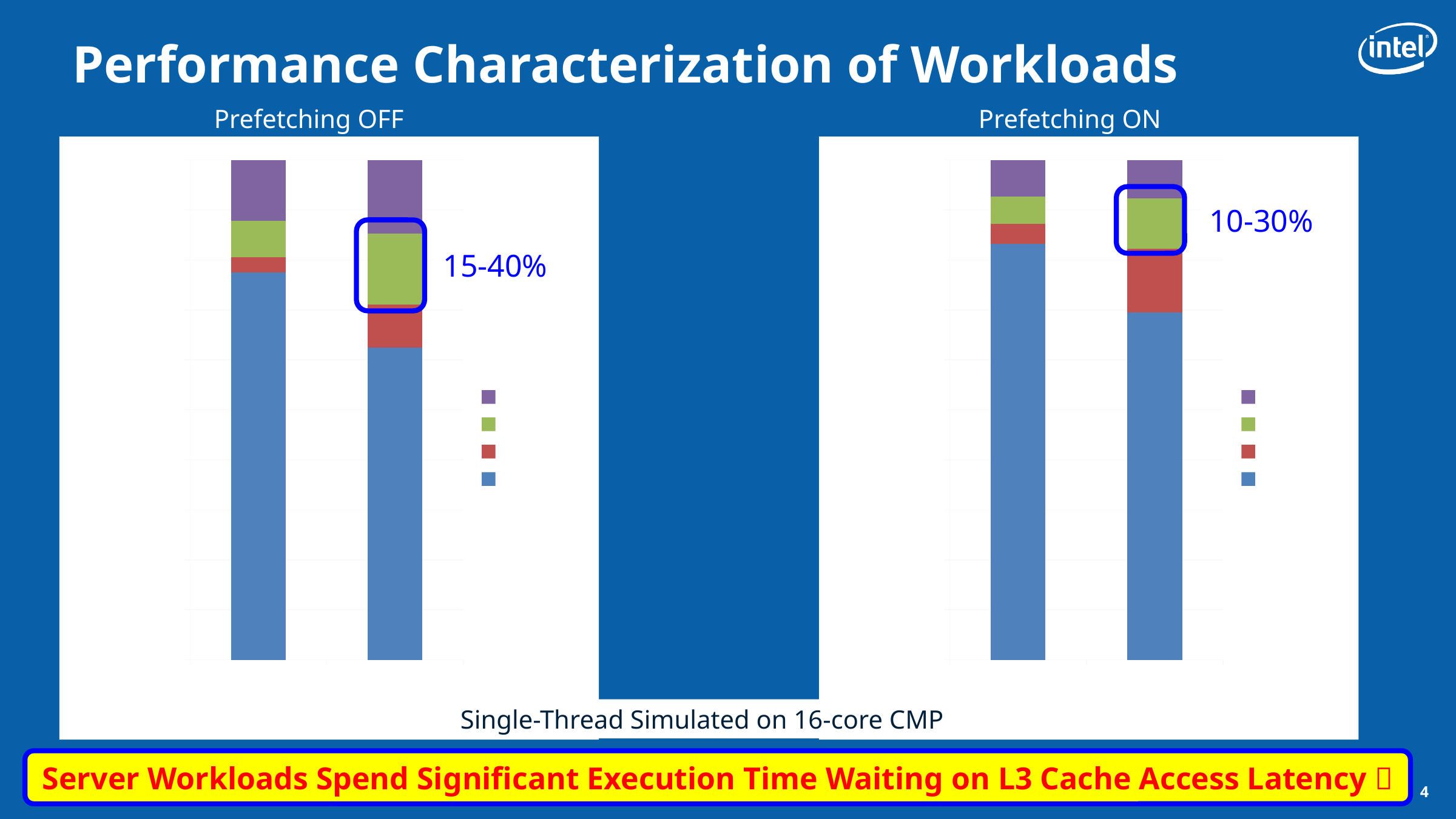
In the "Prefetching ON" chart, what percentage range is annotated next to the highlighted green segment? 10-30% In the "Prefetching OFF" chart, what percentage range is annotated next to the highlighted green segment? 15-40% What are the headings of the two charts on the slide? Prefetching OFF and Prefetching ON How many bars are plotted in the "Prefetching ON" chart? 2 How many bars are plotted in the "Prefetching OFF" chart? 2 How many series does the legend of the "Prefetching OFF" chart list? 4 What kind of chart is shown under the "Prefetching OFF" heading? stacked bar chart In the "Prefetching OFF" chart, which bar has the larger green segment, the left bar or the right bar? right bar What colour is the bottom segment of each stacked bar in both charts? blue How many series does the legend of the "Prefetching ON" chart list? 4 In the "Prefetching ON" chart, which bar has the larger red segment, the left bar or the right bar? right bar In the "Prefetching OFF" chart, which bar has the larger blue segment, the left bar or the right bar? left bar